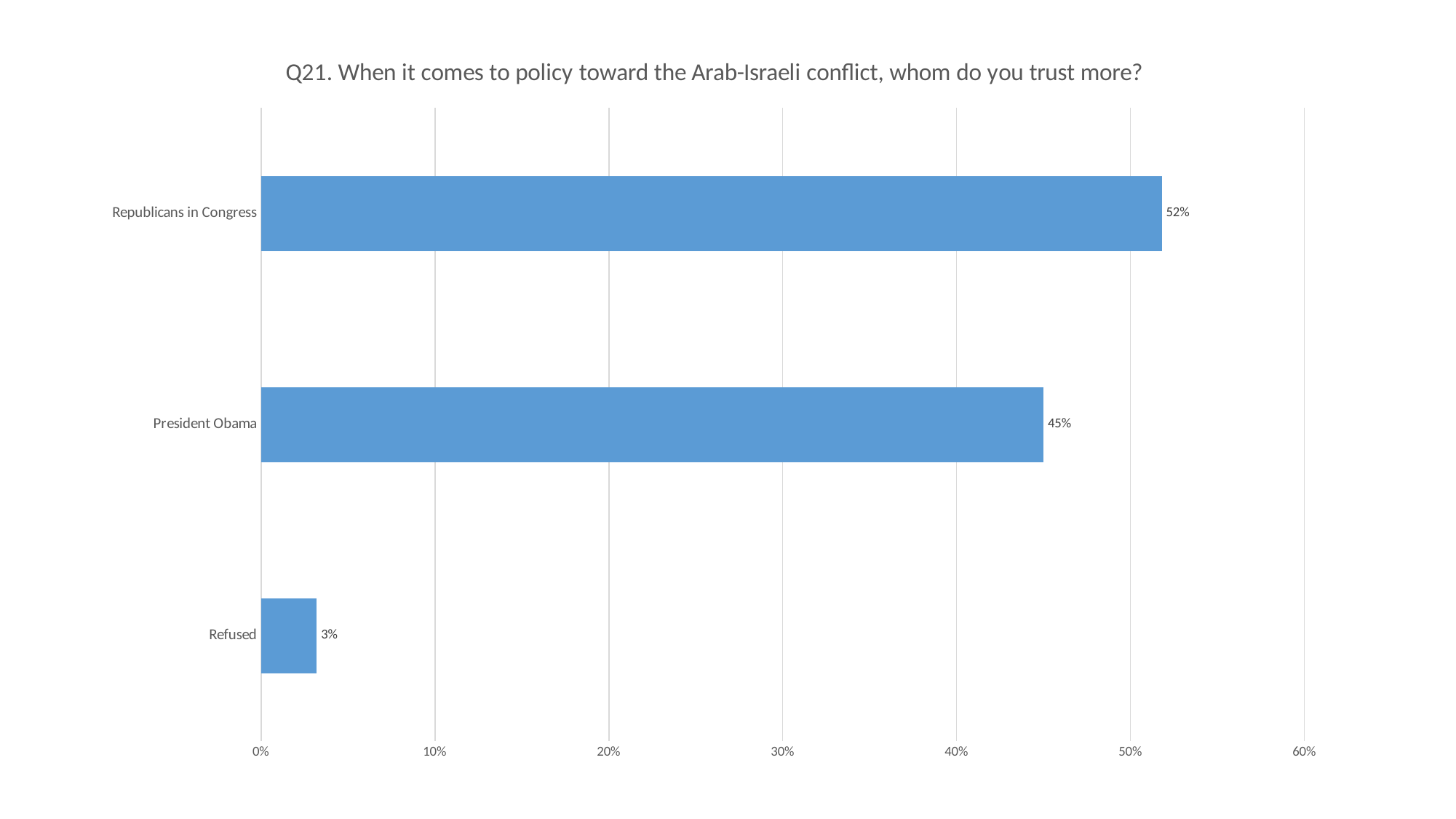
Is the value for Republicans in Congress greater or less than 50%? greater What kind of chart is shown on the slide? Bar chart Is the value for President Obama greater or less than 40%? greater Which is larger, the value for President Obama or the value for Refused? President Obama What percentage of respondents refused to answer? 3% What percentage of respondents said they trust President Obama more? 45% How many categories are shown in the chart? 3 What is the title of the chart? Q21. When it comes to policy toward the Arab-Israeli conflict, whom do you trust more? Which category has the highest value? Republicans in Congress Which category has the lowest value? Refused What is the difference between the values for Republicans in Congress and President Obama? 7% What percentage of respondents said they trust Republicans in Congress more? 52%